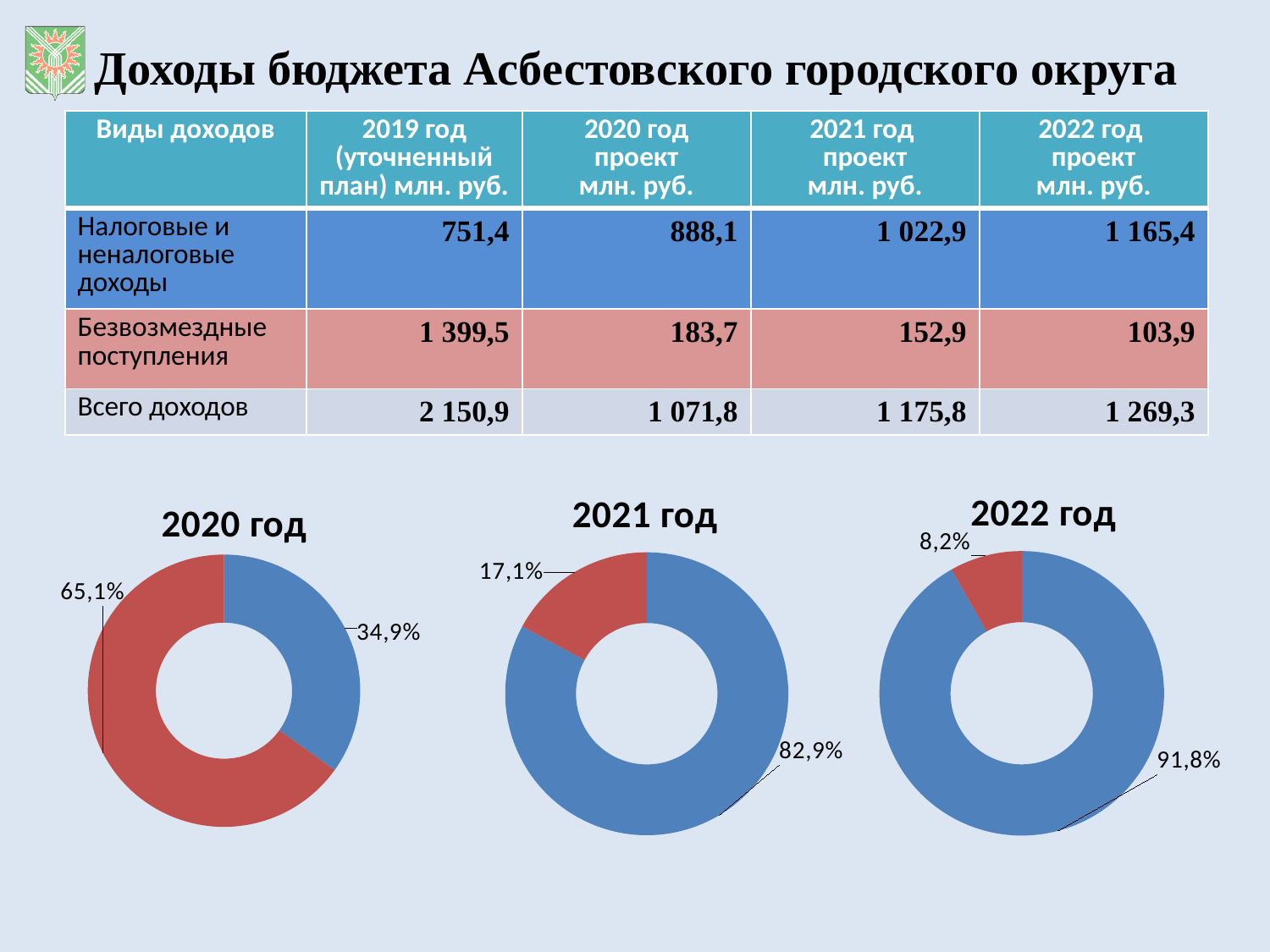
In the chart titled '2022 год', what percentage is labelled on the blue slice? 91,8% In the chart titled '2021 год', what percentage is labelled on the blue slice? 82,9% What kind of chart is the chart titled '2020 год'? doughnut chart In the chart titled '2021 год', which slice is the largest? the blue slice (82,9%) In the chart titled '2022 год', what is the difference in percentage points between the blue slice and the red slice? 83,6 percentage points In the chart titled '2022 год', what percentage is labelled on the red slice? 8,2% How many slices does the chart titled '2022 год' have? 2 In the chart titled '2020 год', what percentage is labelled on the red slice? 65,1% Across the three charts from '2020 год' to '2022 год', does the share of the blue slice rise or fall? rises In the chart titled '2020 год', which slice is larger, the blue one or the red one? red In the chart titled '2021 год', what percentage is labelled on the red slice? 17,1% In the chart titled '2020 год', what percentage is labelled on the blue slice? 34,9%